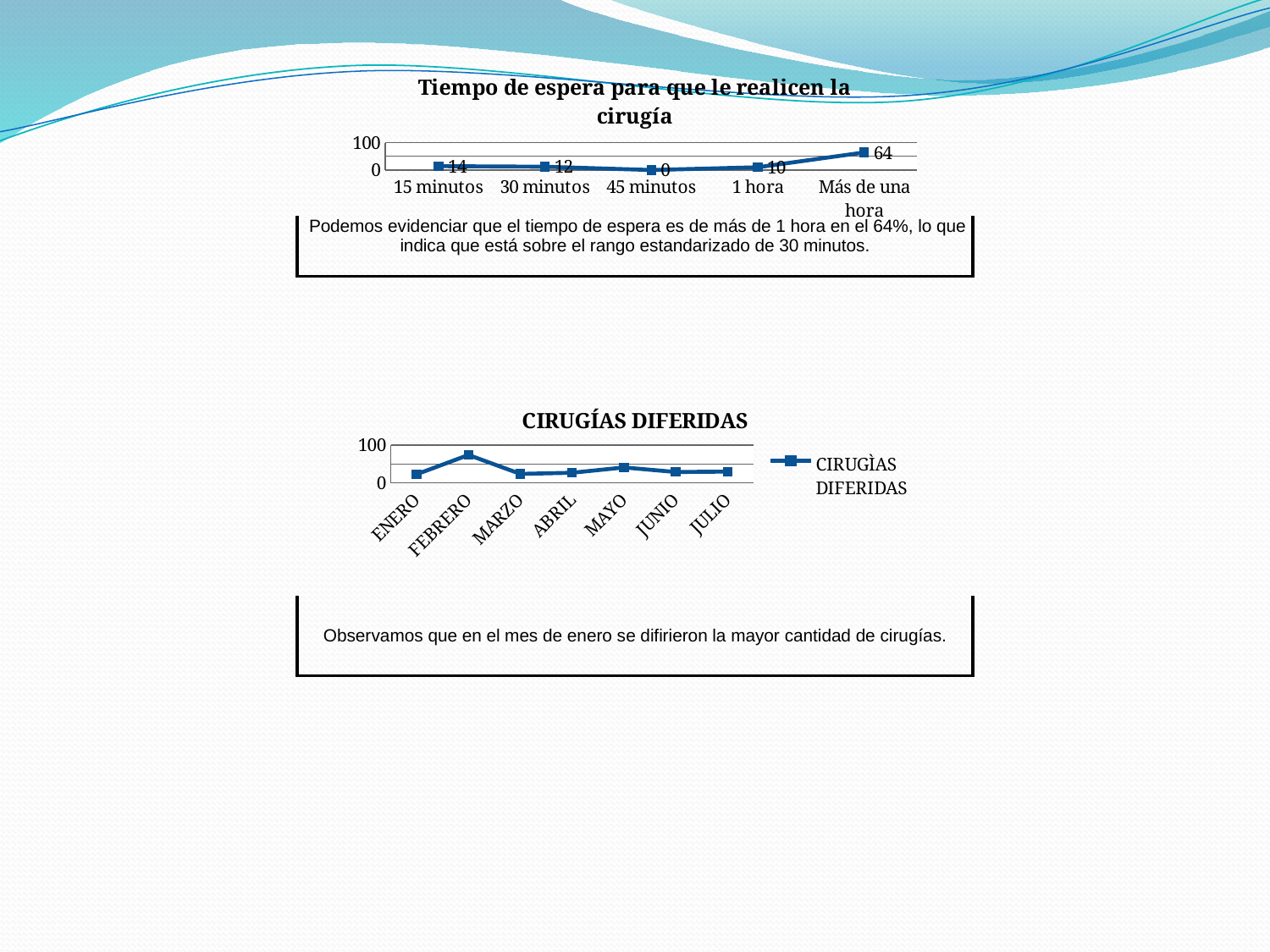
In the chart titled 'Tiempo de espera para que le realicen la cirugía', what is the value for '45 minutos'? 0 In the chart titled 'Tiempo de espera para que le realicen la cirugía', what is the value for '15 minutos'? 14 In the chart titled 'CIRUGÍAS DIFERIDAS', how many months are shown on the x axis? 7 In the chart titled 'Tiempo de espera para que le realicen la cirugía', which is larger, the value for '15 minutos' or '30 minutos'? 15 minutos In the chart titled 'Tiempo de espera para que le realicen la cirugía', how many categories are shown on the x axis? 5 In the chart titled 'CIRUGÍAS DIFERIDAS', is the value for FEBRERO greater or less than 50? greater In the chart titled 'Tiempo de espera para que le realicen la cirugía', what is the difference between the values for 'Más de una hora' and '1 hora'? 54 In the chart titled 'Tiempo de espera para que le realicen la cirugía', which category has the lowest value? 45 minutos In the chart titled 'Tiempo de espera para que le realicen la cirugía', which category has the highest value? Más de una hora In the chart titled 'CIRUGÍAS DIFERIDAS', which month has the highest value? FEBRERO What kind of chart is the chart titled 'CIRUGÍAS DIFERIDAS'? Line chart In the chart titled 'Tiempo de espera para que le realicen la cirugía', what is the value for 'Más de una hora'? 64